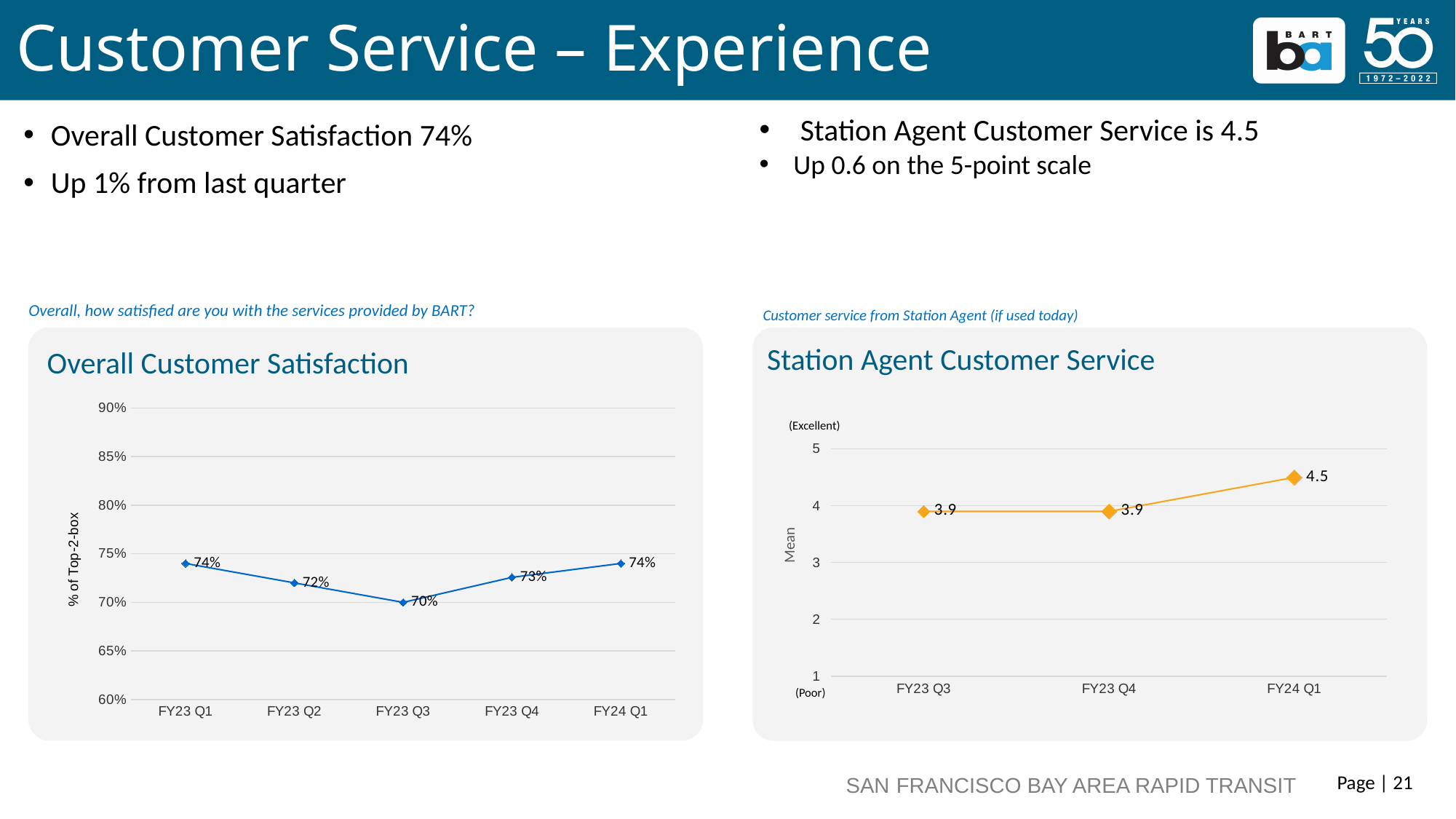
In the Overall Customer Satisfaction chart, is the value for FY23 Q2 greater or less than 75%? less In the Overall Customer Satisfaction chart, how many quarters are plotted? 5 What is the y-axis label of the Overall Customer Satisfaction chart? % of Top-2-box In the Station Agent Customer Service chart, how many quarters are plotted? 3 What kind of chart is the Overall Customer Satisfaction chart? Line chart In the Overall Customer Satisfaction chart, what is the value for FY23 Q3? 70% In the Overall Customer Satisfaction chart, what is the value for FY24 Q1? 74% In the Overall Customer Satisfaction chart, which quarter has the lowest value? FY23 Q3 In the Station Agent Customer Service chart, what is the value for FY24 Q1? 4.5 In the Station Agent Customer Service chart, what is the difference between FY24 Q1 and FY23 Q4? 0.6 In the Station Agent Customer Service chart, what is the value for FY23 Q4? 3.9 In the Overall Customer Satisfaction chart, what is the difference between FY24 Q1 and FY23 Q3? 4%